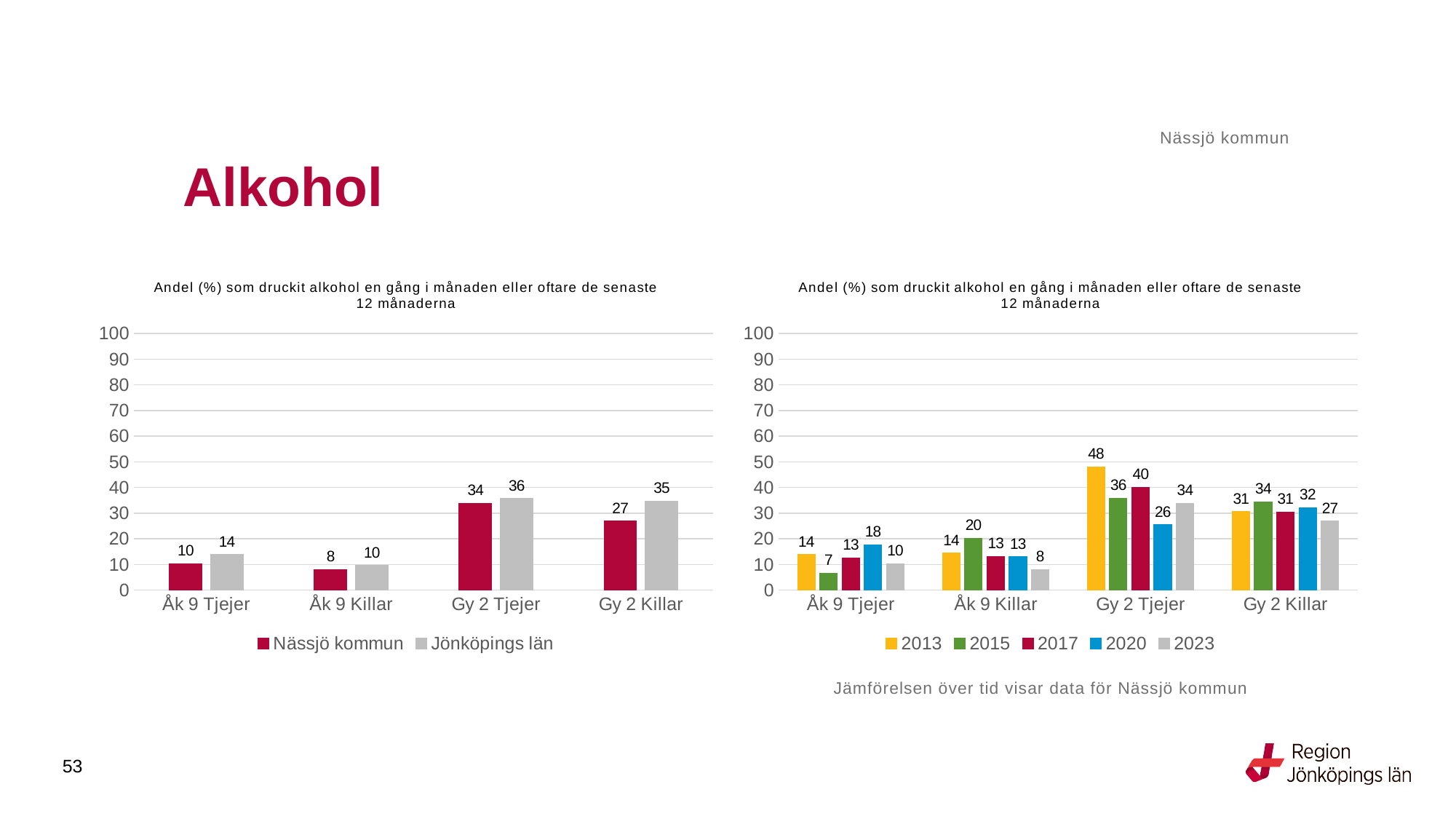
In the left chart, what is the value for Nässjö kommun for Gy 2 Tjejer? 34 In the right chart, how many series does the legend list? 5 In the right chart, what is the value for 2013 for Gy 2 Tjejer? 48 In the right chart, which is larger for Gy 2 Killar: 2015 or 2023? 2015 In the left chart, what is the value for Jönköpings län for Åk 9 Killar? 10 In the left chart, how many series does the legend list? 2 In the left chart, what is the difference between Jönköpings län and Nässjö kommun for Gy 2 Killar? 8 In the left chart, which category has the lowest value for Nässjö kommun? Åk 9 Killar In the right chart, what is the difference between 2013 and 2020 for Gy 2 Tjejer? 22 In the right chart, which year has the highest value for Åk 9 Killar? 2015 What kind of chart is the right chart? Bar chart In the right chart, what is the value for 2020 for Åk 9 Tjejer? 18